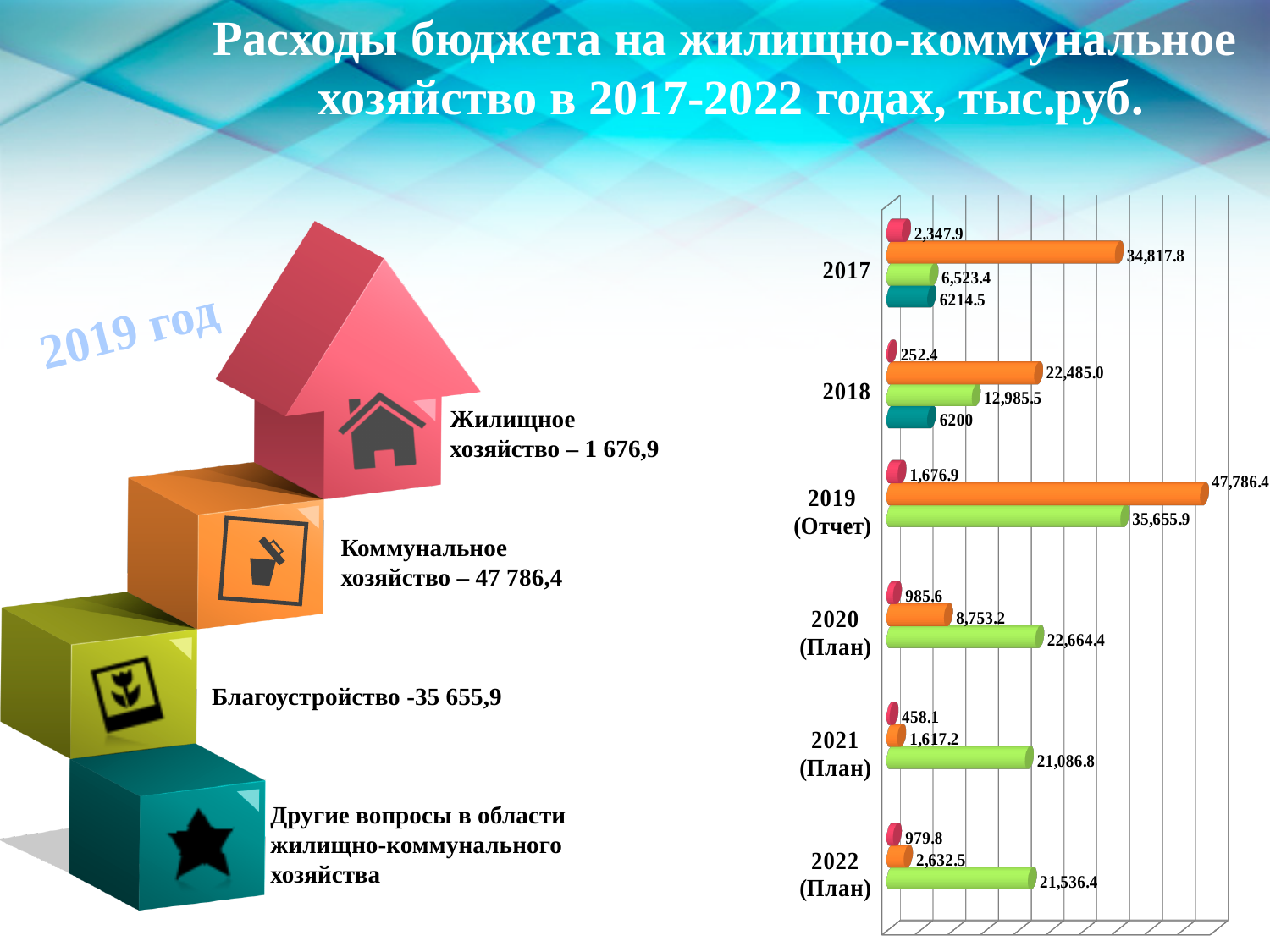
What is the value of the green bar for 2018? 12,985.5 What is the difference between the orange bar and the green bar for 2019 (Отчет)? 12,130.5 How many year groups are shown on the chart's vertical axis? 6 In which year does the orange bar reach its highest value? 2019 (Отчет) In which year is the pink bar the lowest? 2018 What is the value of the pink bar for 2021 (План)? 458.1 According to the slide title, in what units are the budget expenditures given? тыс.руб. What is the value of the orange bar for 2017? 34,817.8 What is the value of the green bar for 2022 (План)? 21,536.4 Does the orange bar rise or fall from 2019 (Отчет) to 2021 (План)? fall What type of chart is shown on the right side of the slide? bar chart For 2018, which is larger: the orange bar or the green bar? the orange bar